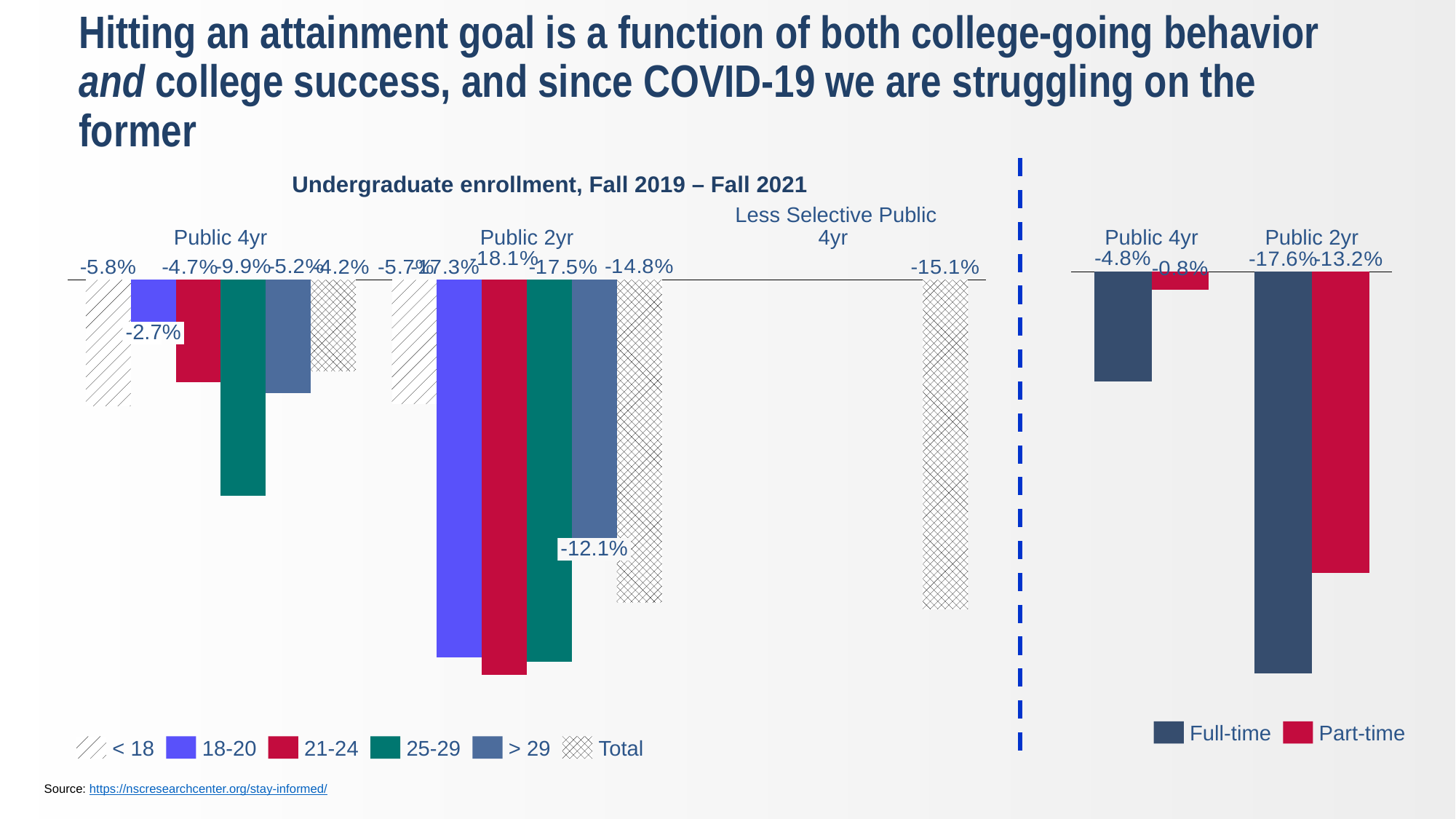
In the right chart, which bar shows the largest decline? Public 2yr Full-time In the left chart, what is the value for the 18-20 age group at Public 4yr? -2.7% In the left chart, what is the Total value for Less Selective Public 4yr? -15.1% What kind of chart is the left chart titled 'Undergraduate enrollment, Fall 2019 – Fall 2021'? Bar chart In the left chart, what is the Total value for Public 2yr? -14.8% In the right chart, what is the difference between the Full-time and Part-time values for Public 2yr? 4.4 percentage points How many series does the legend of the right chart list? 2 In the right chart, what is the Full-time value for Public 2yr? -17.6% In the left chart, what is the value for the 25-29 age group at Public 4yr? -9.9% How many series does the legend of the left chart list? 6 In the right chart, what is the Full-time value for Public 4yr? -4.8% In the left chart, what is the value for the > 29 age group at Public 2yr? -12.1%